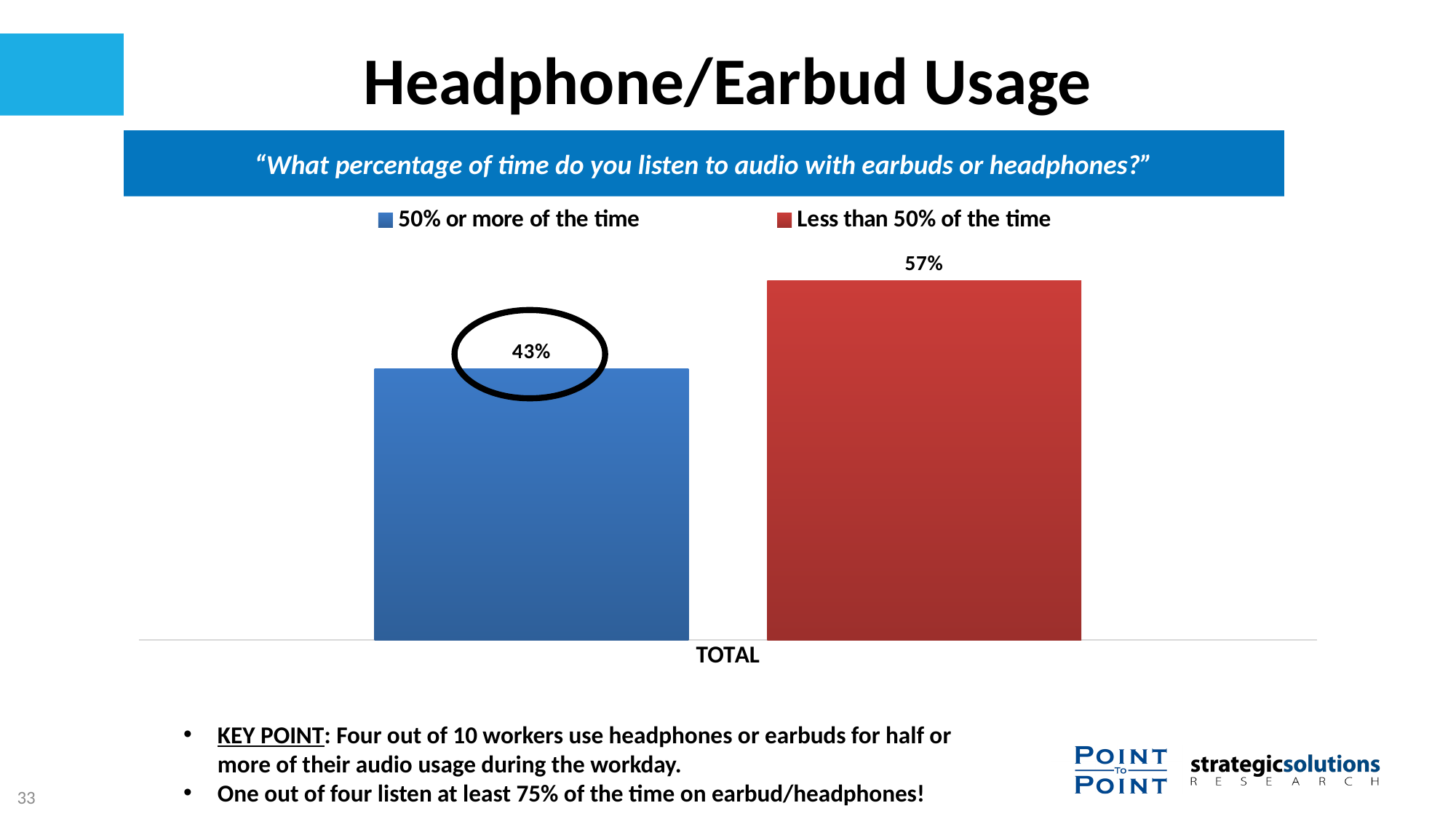
What is the label of the category on the x axis? TOTAL What is the value for "Less than 50% of the time" in the TOTAL category? 57% Which series has the highest value on the chart? Less than 50% of the time How many categories are shown on the x axis? 1 What is the value for "50% or more of the time" in the TOTAL category? 43% What is the difference between the "Less than 50% of the time" value and the "50% or more of the time" value? 14% What is the total of the two bars in the TOTAL category? 100% Which series has the higher value: "50% or more of the time" or "Less than 50% of the time"? Less than 50% of the time What colour is the bar for "Less than 50% of the time"? Red What kind of chart is shown on the slide? Bar chart How many series does the legend list? 2 Which series has the lowest value on the chart? 50% or more of the time